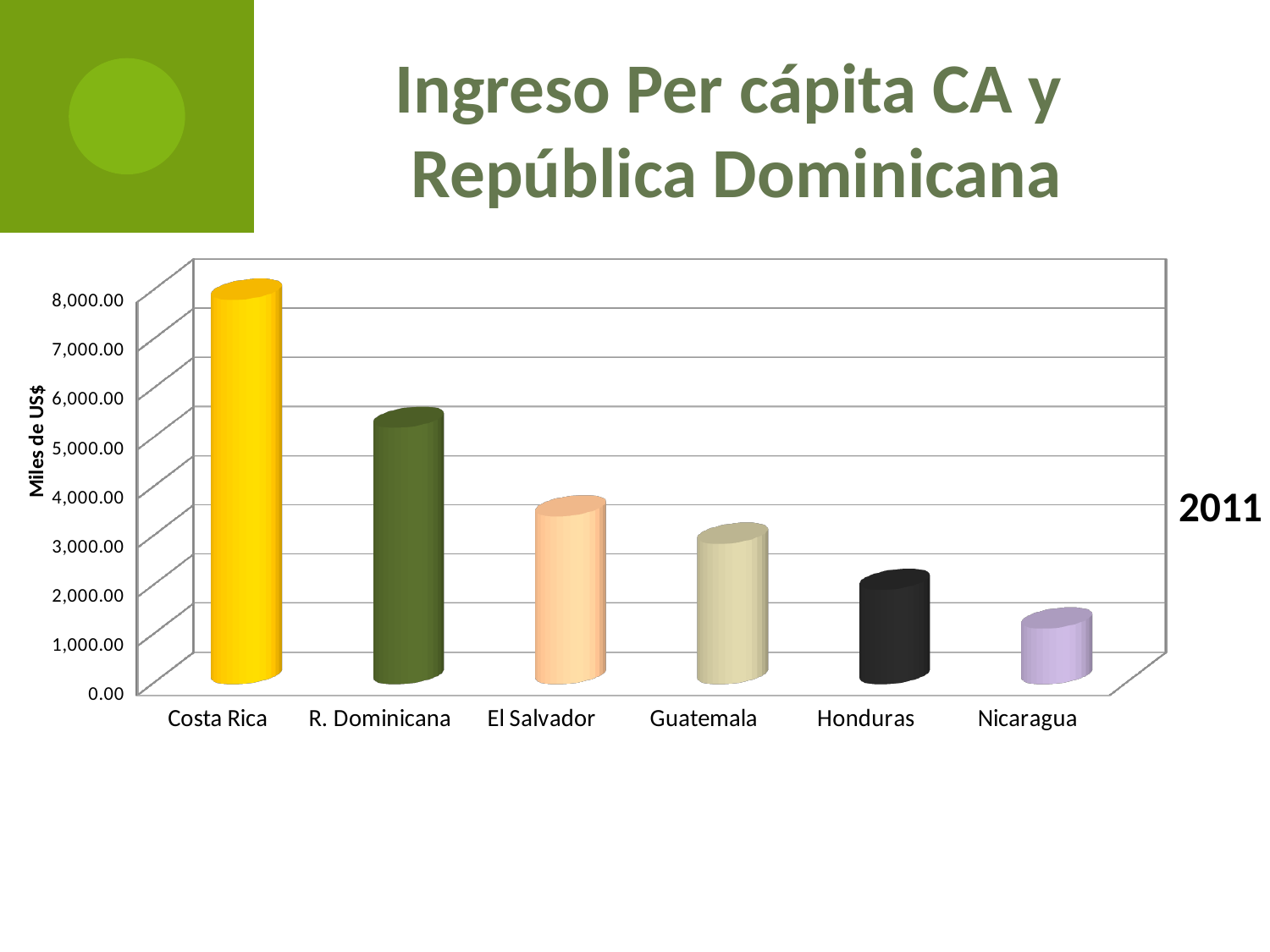
Which has a higher value, Guatemala or Honduras? Guatemala Do the values rise or fall moving from left to right along the x axis? fall What is the label on the vertical axis of the chart? Miles de US$ Which has a higher value, Costa Rica or R. Dominicana? Costa Rica Is the value for El Salvador greater or less than 3,000.00? greater Which country has the highest per capita income in the chart? Costa Rica Which country has the lowest per capita income in the chart? Nicaragua Is the value for Nicaragua greater or less than 2,000.00? less What kind of chart is shown on the slide? bar chart Is the value for Costa Rica greater or less than 7,000.00? greater How many countries are shown on the x axis of the chart? 6